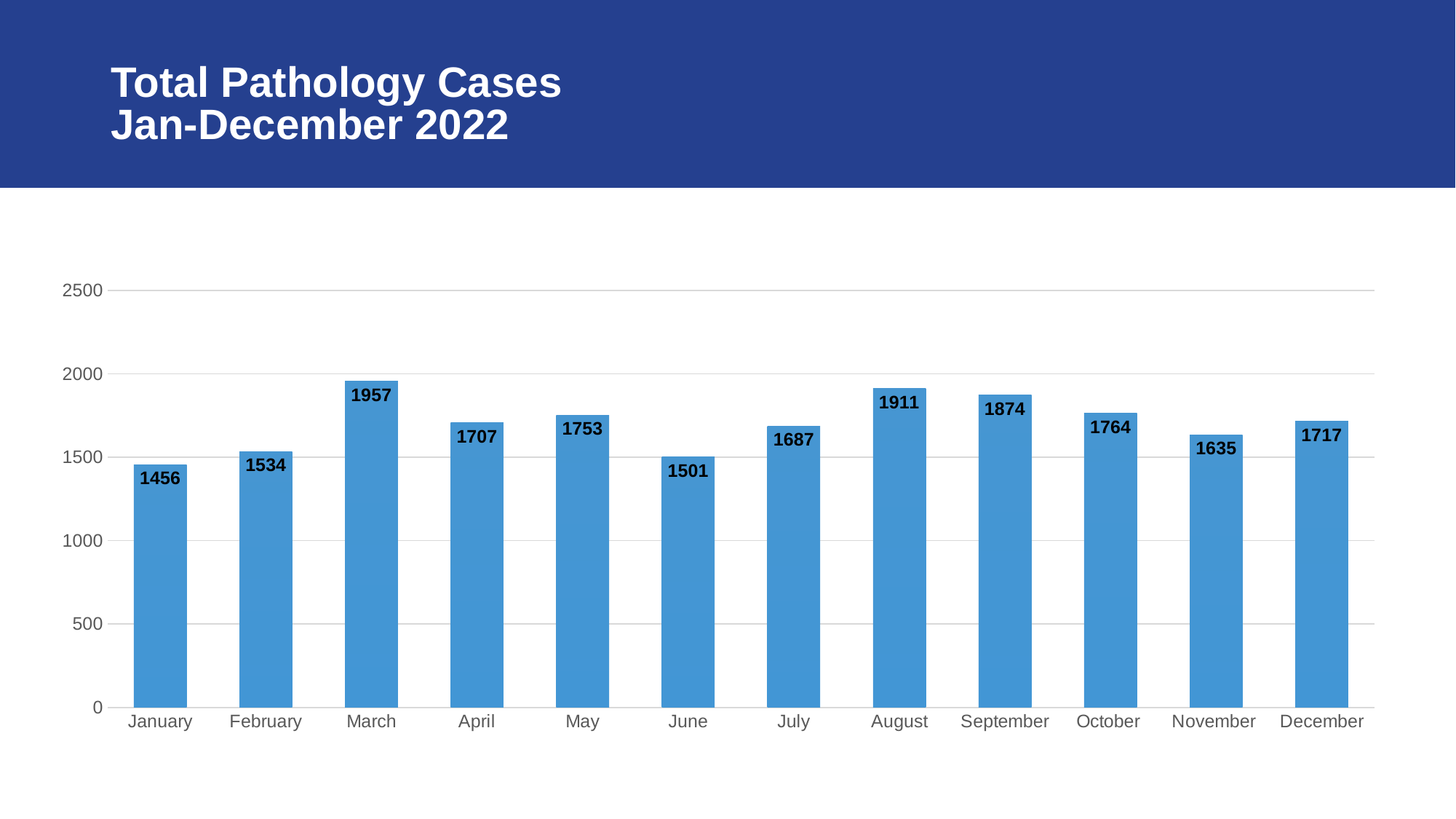
What is the title of the slide? Total Pathology Cases Jan-December 2022 What is the value for March? 1957 Is the value for November greater or less than 1500? greater Which month has the highest value? March Which month has the lowest value? January What is the value for June? 1501 What kind of chart is shown on the slide? bar chart What is the value for October? 1764 How many months are shown on the x axis? 12 What is the difference between the values for March and January? 501 Which is larger, the value for May or the value for July? May What is the difference between the values for August and September? 37